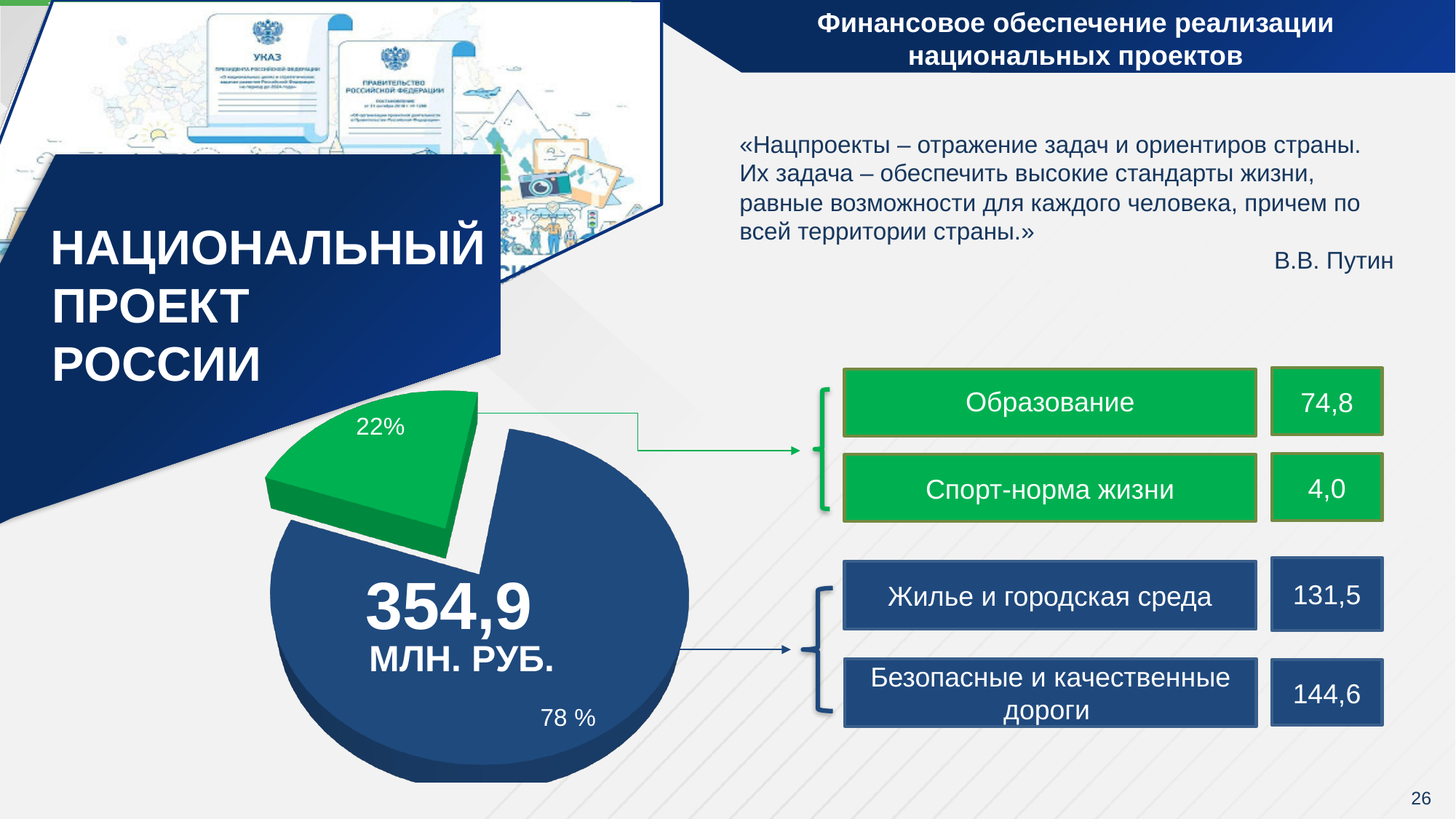
What value is shown for Безопасные и качественные дороги? 144,6 What share of the pie does the blue slice represent? 78 % Which of the four national projects listed next to the pie chart has the highest value? Безопасные и качественные дороги Which of the four national projects listed next to the pie chart has the lowest value? Спорт-норма жизни How many slices does the pie chart have? 2 What value is shown for Образование in the boxes linked to the green slice? 74,8 What value is shown for Спорт-норма жизни? 4,0 What is the difference in percentage points between the blue slice and the green slice? 56 What total amount is printed in the centre of the pie chart? 354,9 млн. руб. Which slice of the pie is larger, the green one or the blue one? the blue one What kind of chart is shown on the slide? pie chart What share of the pie does the green slice represent? 22%